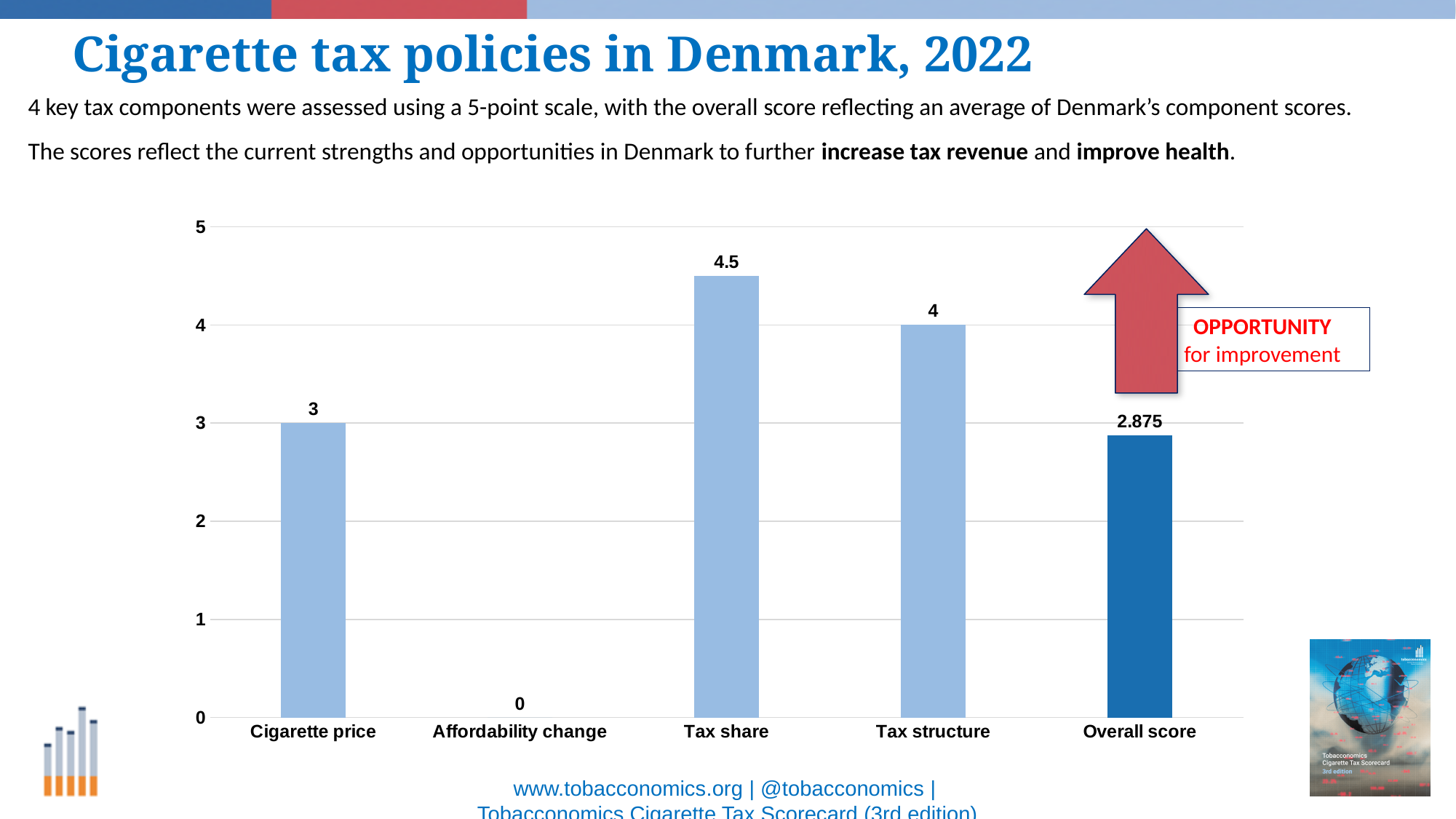
What is the value for Cigarette price? 3 How many categories are shown on the x axis? 5 What is the value for Affordability change? 0 What is the difference between the values for Tax structure and Cigarette price? 1 Which category has the highest value? Tax share What is the Overall score? 2.875 Which category has the lowest value? Affordability change What is the difference between the values for Tax share and Tax structure? 0.5 Which is larger, the value for Cigarette price or the Overall score? Cigarette price What kind of chart is shown on the slide? Bar chart What is the value for Tax share? 4.5 What is the maximum value shown on the y axis? 5